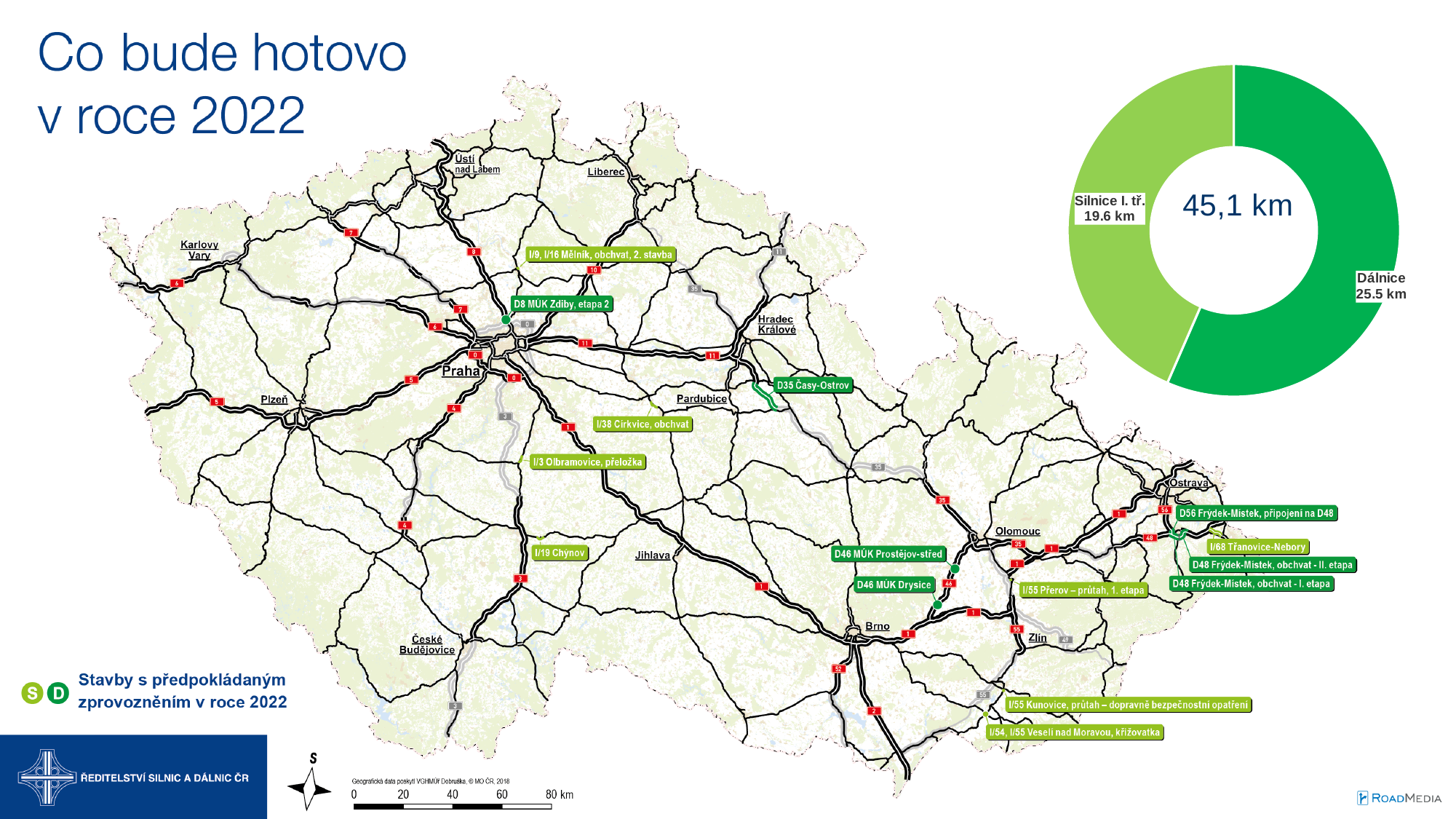
Which category has the larger value in the donut chart, Dálnice or Silnice I. tř.? Dálnice Which category has the largest value in the donut chart? Dálnice What value is shown for Dálnice in the donut chart? 25.5 km What kind of chart is shown on the slide? Donut (pie) chart How many categories does the donut chart show? 2 Which colour represents Dálnice in the donut chart, the darker green or the lighter green? Darker green What is the title of the slide containing the donut chart? Co bude hotovo v roce 2022 What total value is printed in the centre of the donut chart? 45,1 km What value is shown for Silnice I. tř. in the donut chart? 19.6 km Which category has the smallest value in the donut chart? Silnice I. tř. What is the difference between the Dálnice value and the Silnice I. tř. value in the donut chart? 5.9 km